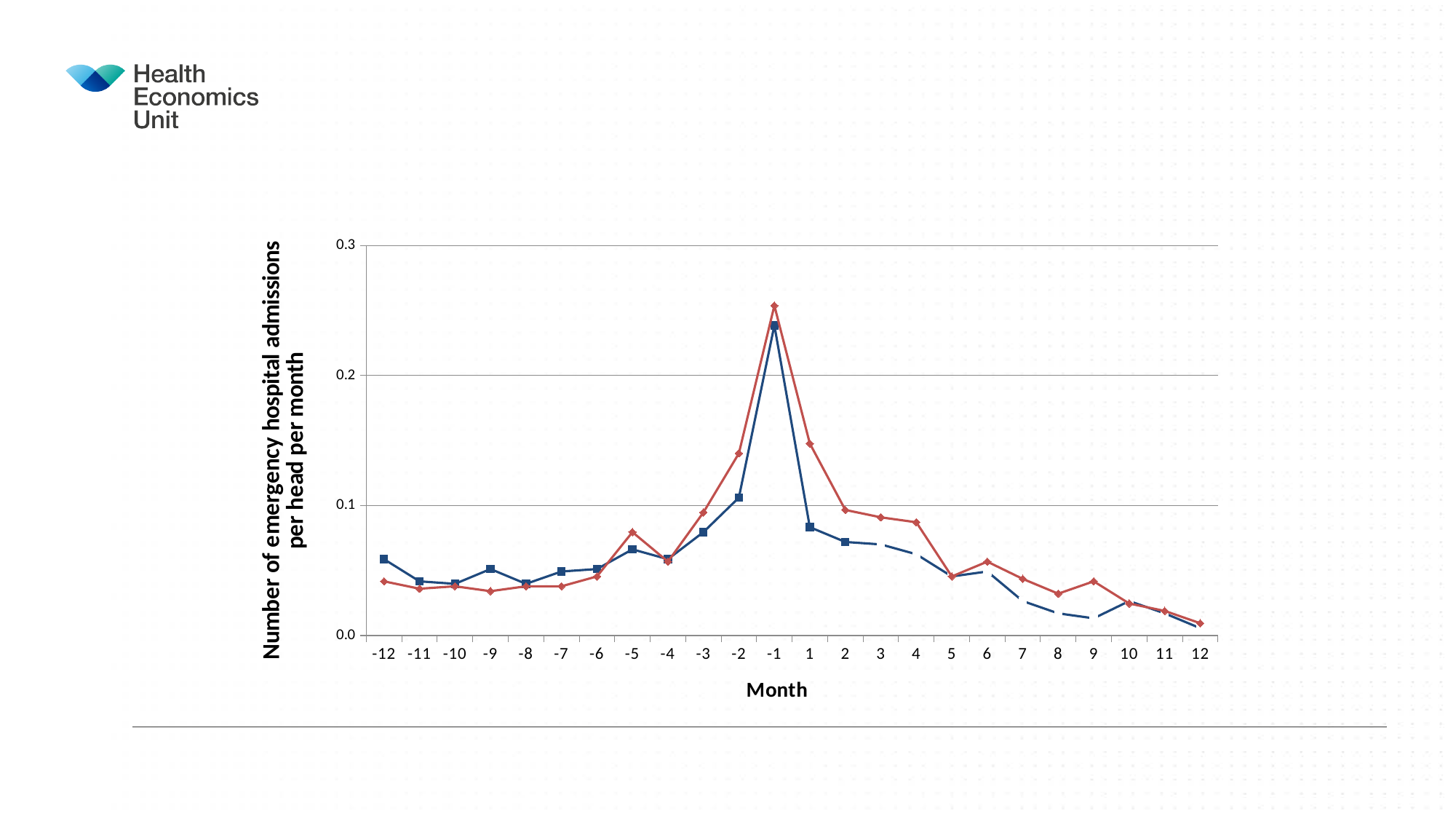
At month -12, which line has the higher value, the red line or the blue line? Blue line At month 1, which line has the higher value, the red line or the blue line? Red line How many month values are shown along the x axis? 24 Is the value of the blue line at month 12 greater or less than 0.1? less From month -1 to month 12, does the red line generally rise or fall? Fall At which month does the blue line reach its highest value? -1 What kind of chart is shown on the slide? Line chart How many lines are plotted on the chart? 2 What is the title of the y axis? Number of emergency hospital admissions per head per month At which month does the red line reach its highest value? -1 Is the value of the red line at month -1 greater or less than 0.2? greater Is the value of the red line at month 1 greater or less than 0.1? greater